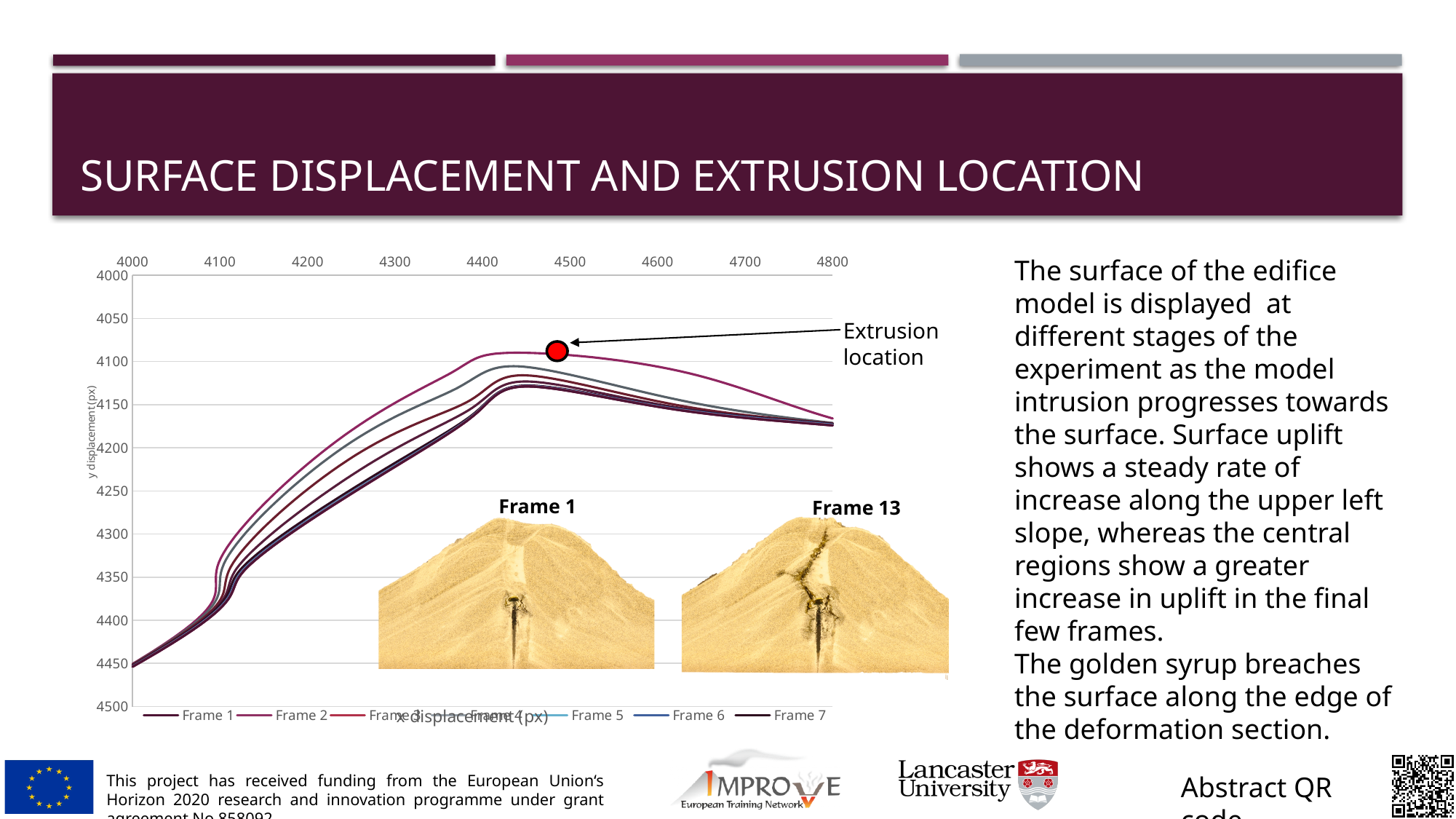
At x displacement 4000, is the y displacement value of the curves greater or less than 4400? greater Is the y displacement value of the Frame 1 curve at x displacement 4200 greater or less than 4200? greater What kind of chart is shown on the slide? Line chart What is the label of the first series in the chart's legend? Frame 1 What does the red dot on the chart mark, according to the annotation? Extrusion location How many series does the chart's legend list? 7 At x displacement 4800, is the y displacement value of the curves greater or less than 4200? less